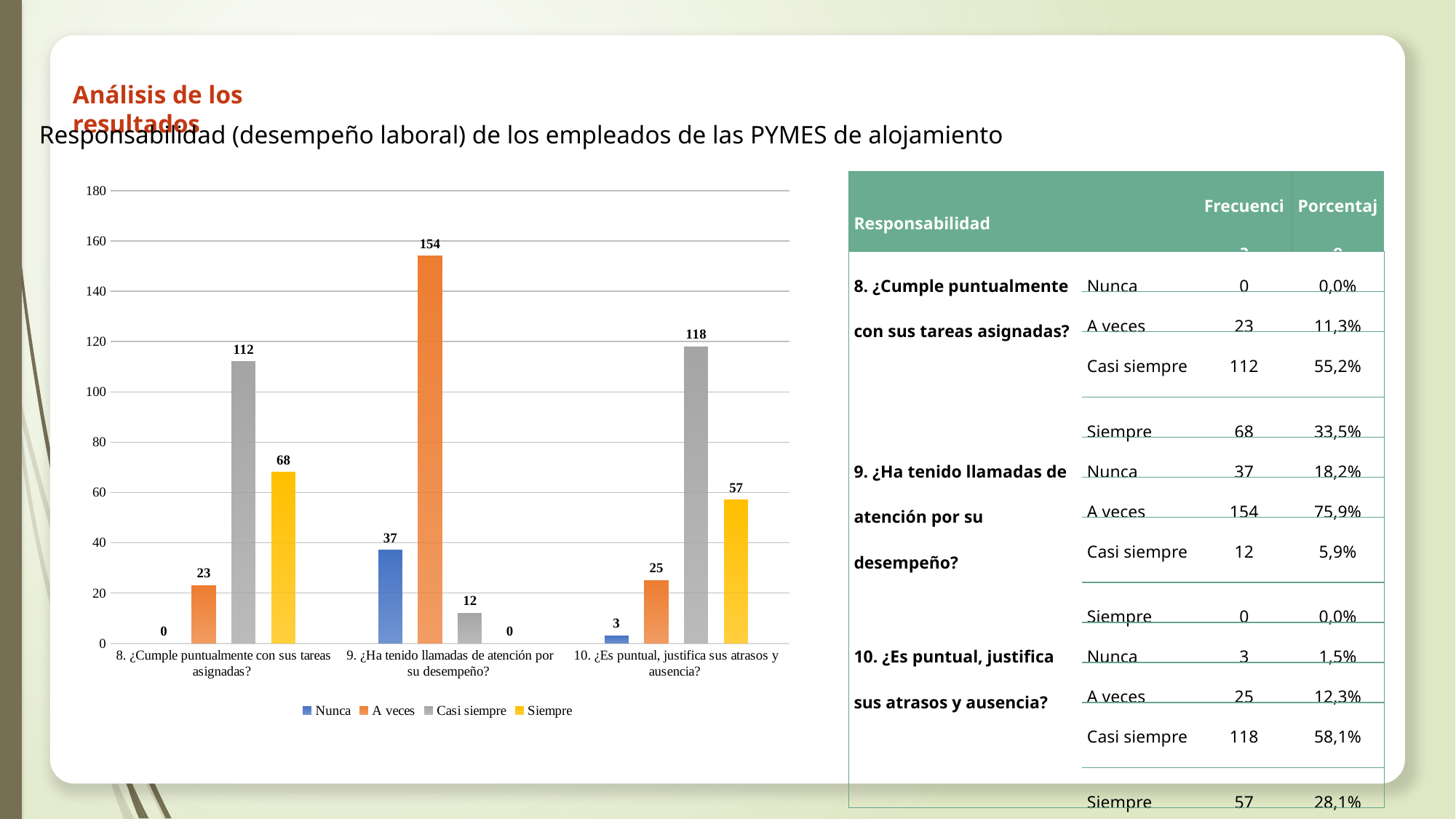
How many series does the chart legend list? 4 Which series has the highest value in the category "10. ¿Es puntual, justifica sus atrasos y ausencia?"? Casi siempre What colour represents the "Siempre" series in the chart? Yellow What is the difference between the "Casi siempre" and "Siempre" values in the category "8. ¿Cumple puntualmente con sus tareas asignadas?"? 44 How many categories are shown on the x axis of the chart? 3 What is the value for "Siempre" in the category "10. ¿Es puntual, justifica sus atrasos y ausencia?"? 57 What is the value for "A veces" in the category "9. ¿Ha tenido llamadas de atención por su desempeño?"? 154 What is the value for "Casi siempre" in the category "8. ¿Cumple puntualmente con sus tareas asignadas?"? 112 Which series has the lowest value in the category "9. ¿Ha tenido llamadas de atención por su desempeño?"? Siempre Is the "A veces" value for question 9 greater or less than 140? greater What kind of chart is shown on the slide? Bar chart Which is larger: the "Nunca" value for question 9 or the "A veces" value for question 10? Nunca for question 9